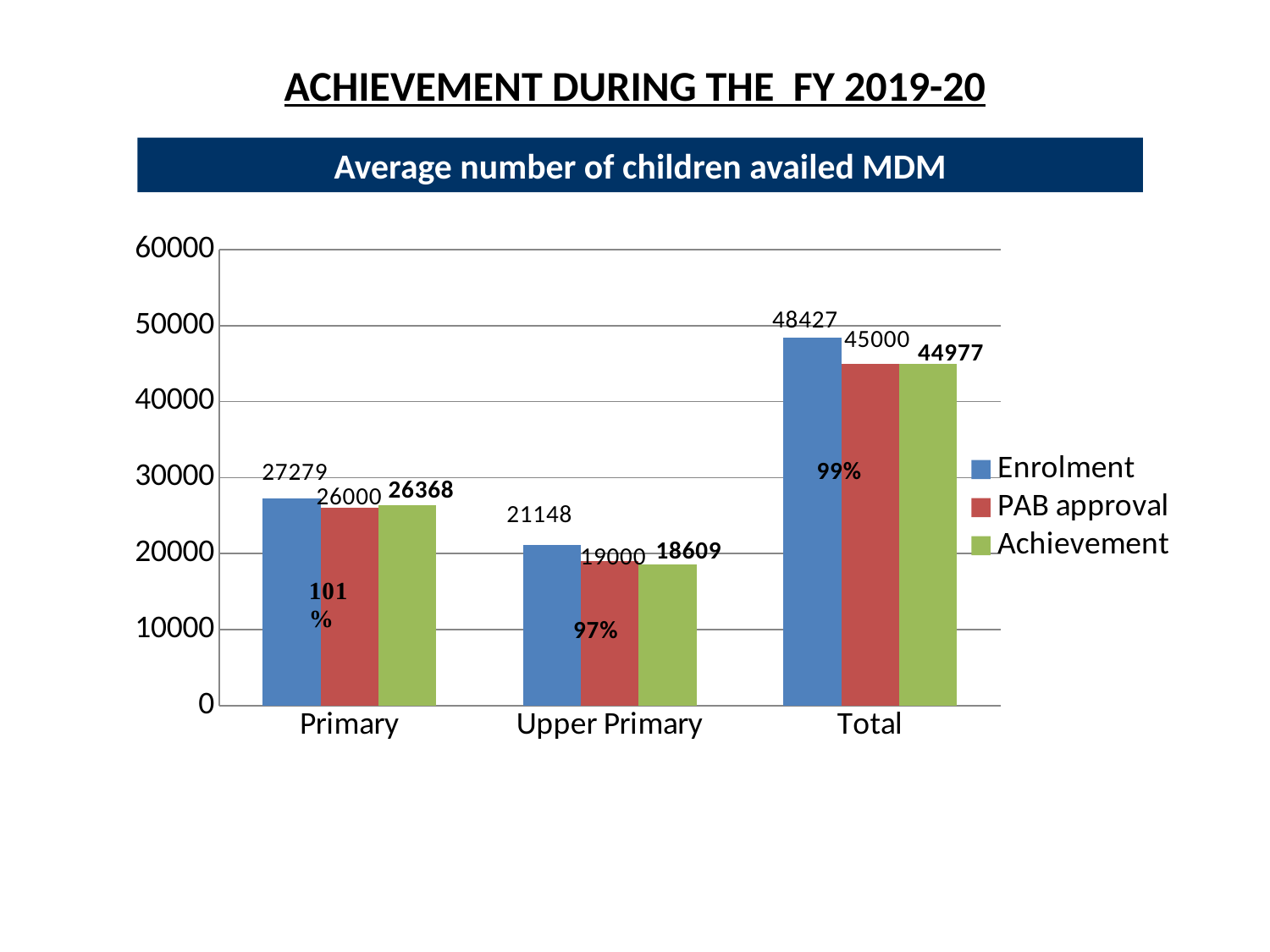
Which is larger for Primary: PAB approval or Achievement? Achievement What is the Enrolment value for Primary? 27279 What kind of chart is shown on the slide? bar chart Which category has the highest Enrolment value? Total What is the PAB approval value for Upper Primary? 19000 Is the Enrolment value for Upper Primary greater or less than 20000? greater How many categories are shown on the x axis? 3 What is the Achievement value for Total? 44977 What percentage label is shown on the Upper Primary group? 97% How many series does the legend list? 3 Which category has the lowest Achievement value? Upper Primary What is the difference between Enrolment and PAB approval for Total? 3427